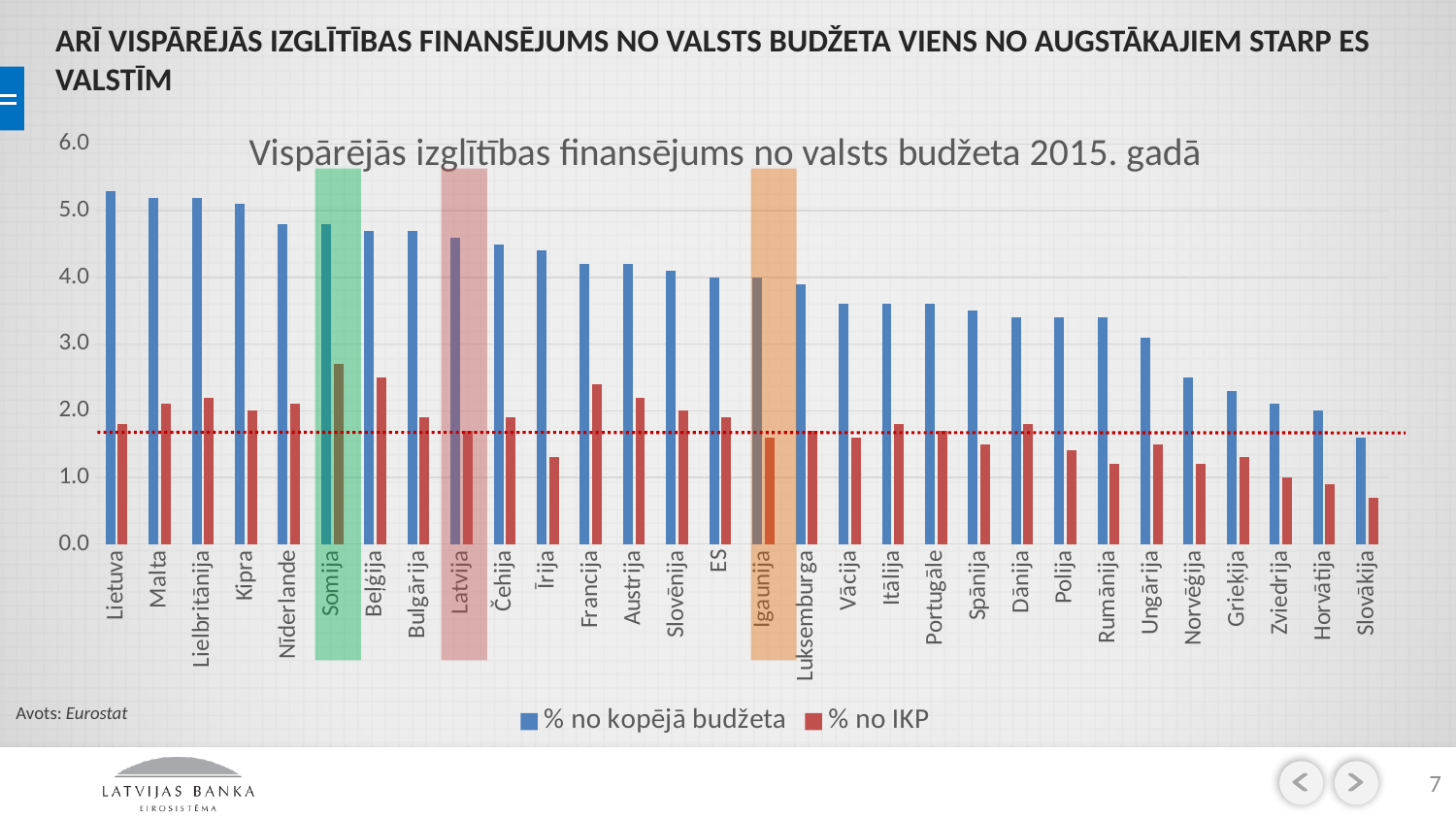
Is the '% no kopējā budžeta' value for Latvija greater or less than 4.0? greater How many series does the legend list? 2 Is the '% no kopējā budžeta' value for Slovākija greater or less than 2.0? less Is the '% no IKP' value for Somija greater or less than 2.0? greater What kind of chart is shown on the slide? bar chart Do the '% no kopējā budžeta' values generally rise or fall from left to right along the x axis? fall Which category has the highest value for '% no IKP'? Somija Which is larger, the '% no IKP' value for Somija or for Latvija? Somija How many countries/categories are shown on the x axis? 30 Which category has the highest value for '% no kopējā budžeta'? Lietuva Which category has the lowest value for '% no kopējā budžeta'? Slovākija